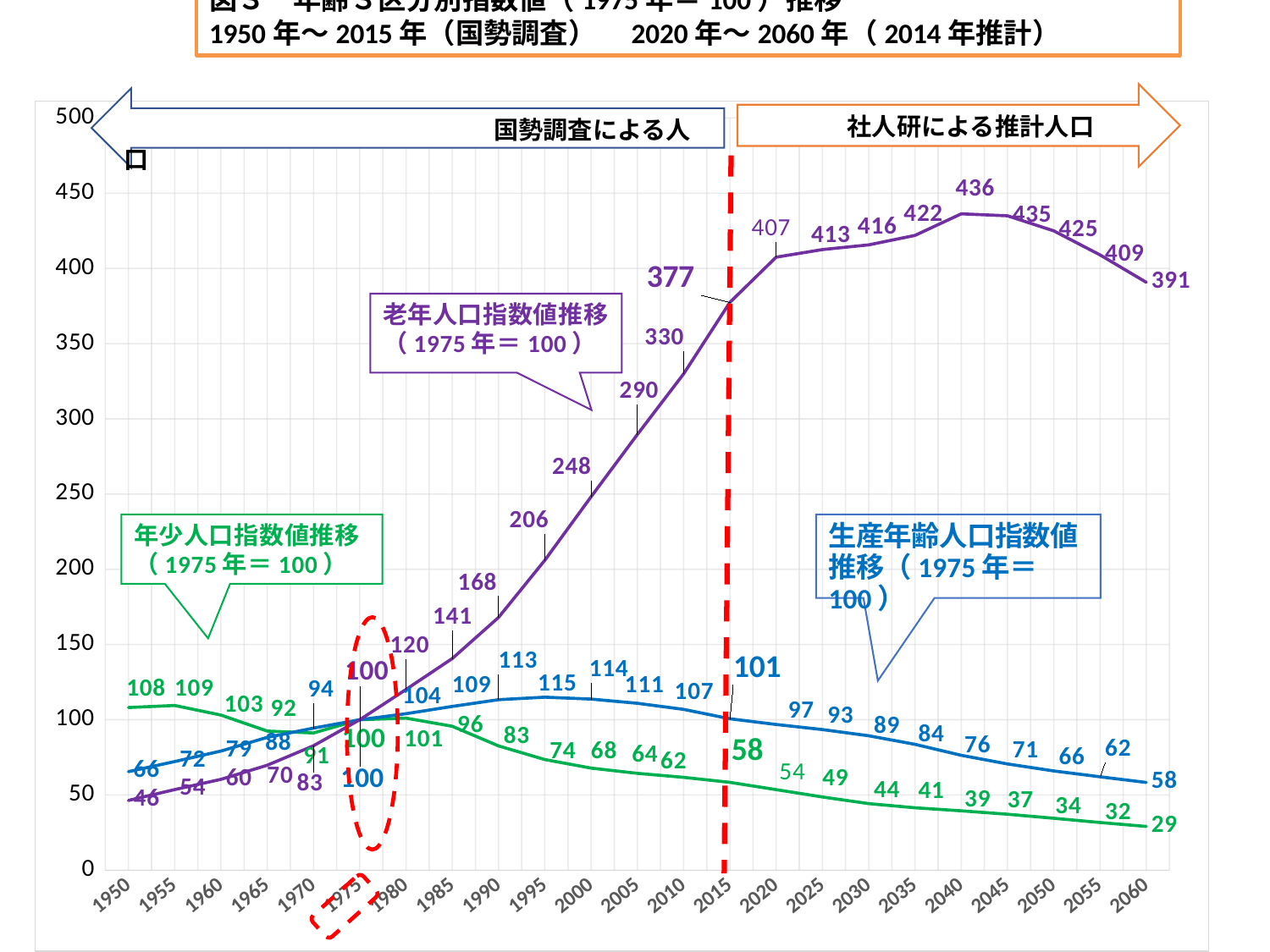
What is the value of the 年少人口指数値推移 series in 2060? 29 What is the value of the 老年人口指数値推移 series in 2040? 436 What value do all three series share in 1975? 100 In which year does the 老年人口指数値推移 series reach its highest value? 2040 Which series has the larger value in 1950, 年少人口指数値推移 or 生産年齢人口指数値推移? 年少人口指数値推移 What is the difference between the 老年人口指数値推移 value in 2015 (377) and in 2010 (330)? 47 How many years are marked on the x axis of the chart? 23 What is the value of the 生産年齢人口指数値推移 series in 2015? 101 How does the 年少人口指数値推移 series change from 1990 to 2060? It falls Is the value of the 老年人口指数値推移 series in 2060 greater or less than 350? greater What type of chart is shown on the slide? line chart In which year does the 生産年齢人口指数値推移 series reach its highest value? 1995